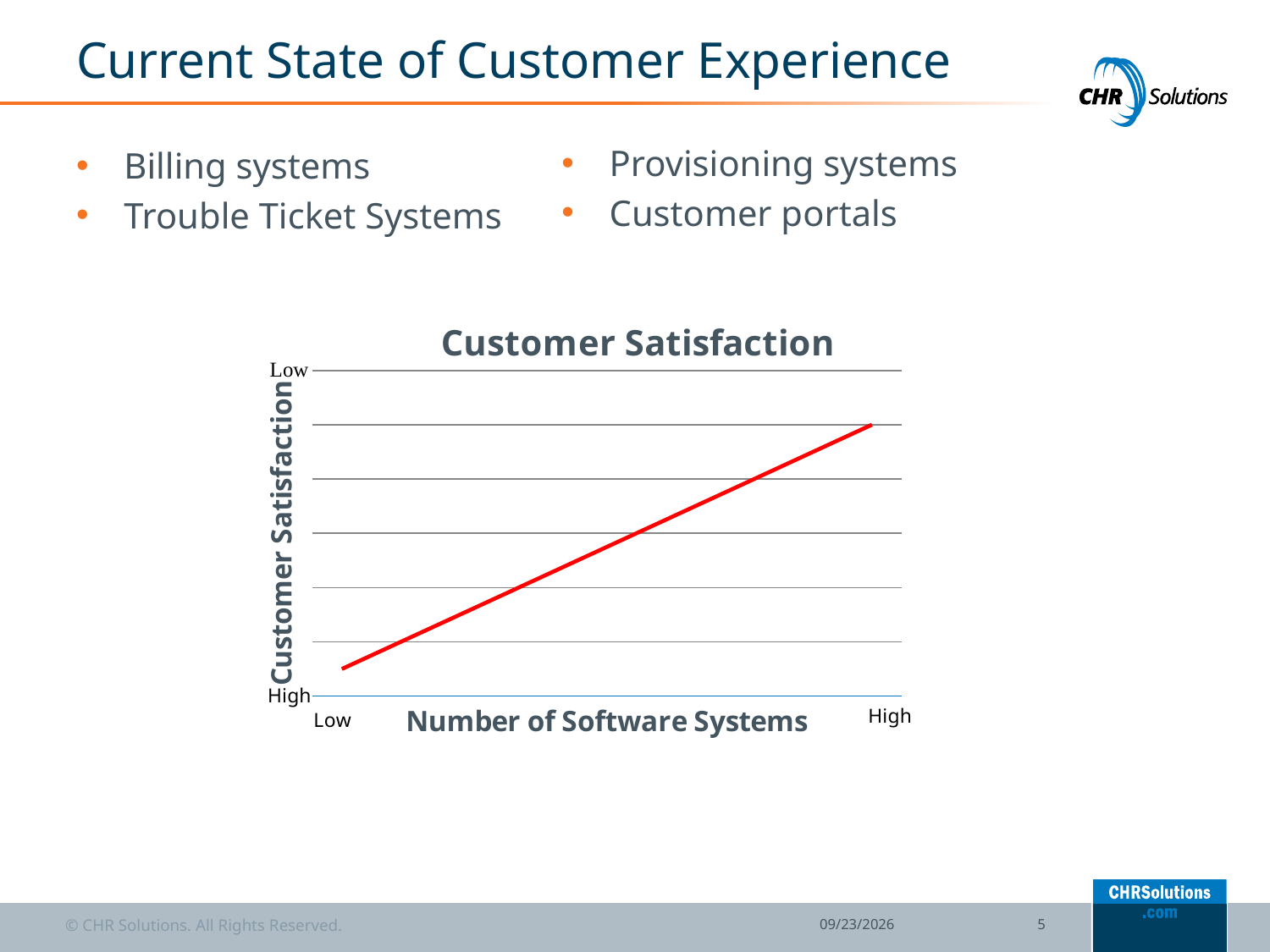
What is the label of the horizontal axis in the "Customer Satisfaction" chart? Number of Software Systems What is the title of the chart on the slide? Customer Satisfaction What kind of chart is shown under the title "Customer Satisfaction"? line chart According to the "Customer Satisfaction" chart, as the number of software systems goes from Low to High, does customer satisfaction move from High to Low or from Low to High? High to Low In the "Customer Satisfaction" chart, does the red line rise or fall from left to right? rises